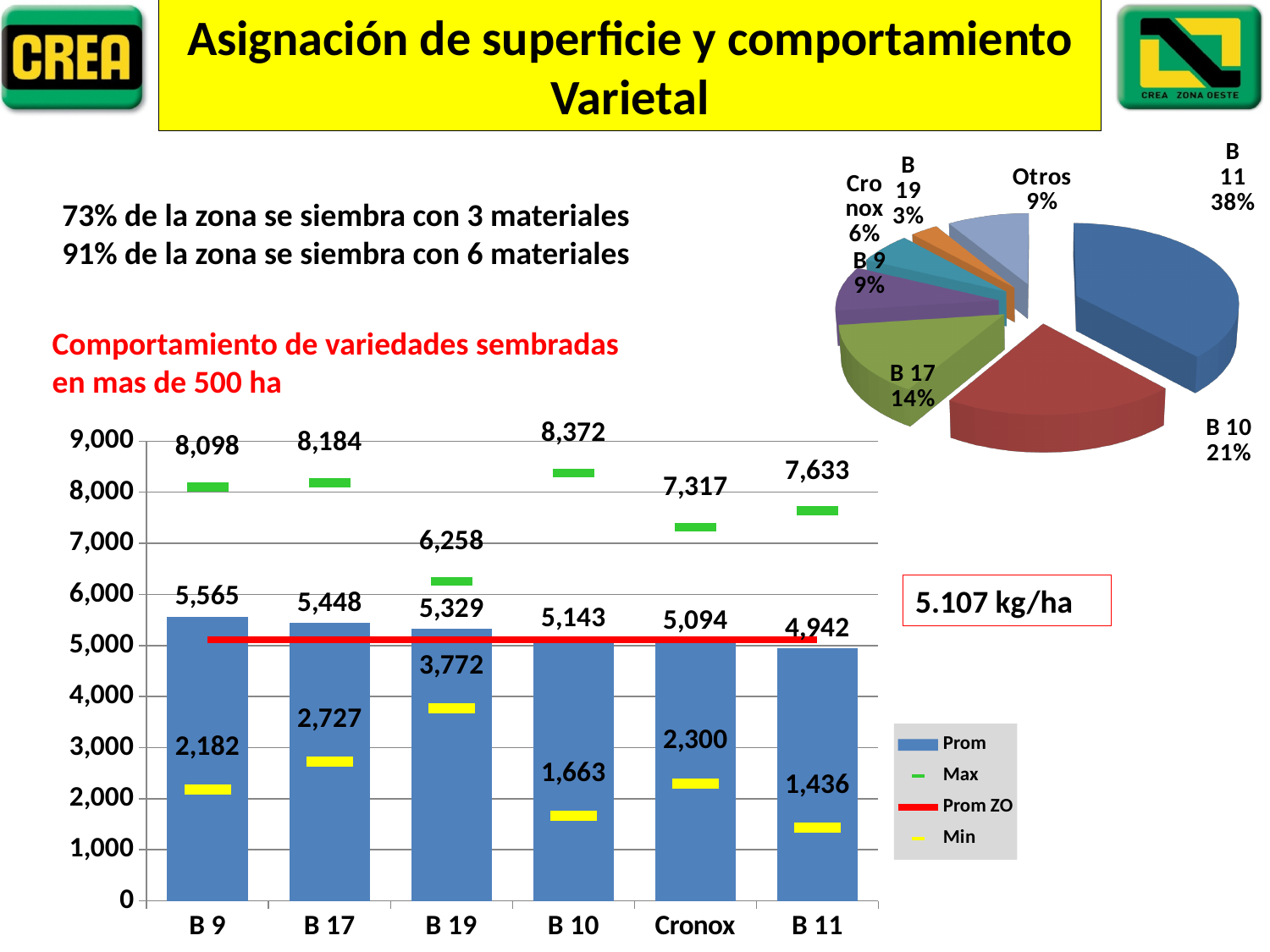
In the pie chart at the top right, which slice is the smallest? B 19 In the bar chart at the bottom left, do the Prom values rise or fall from B 9 to B 11 along the x axis? fall In the bar chart at the bottom left, what is the Min value for B 11? 1,436 In the bar chart at the bottom left, what is the difference between the Max and Min values for B 19? 2,486 In the bar chart at the bottom left, what is the Prom value for B 9? 5,565 In the bar chart at the bottom left, which category has the lowest Prom value? B 11 In the bar chart at the bottom left, what is the Max value for B 10? 8,372 In the bar chart at the bottom left, which is larger, the Prom value for B 17 or the Prom value for Cronox? B 17 In the pie chart at the top right, how many slices are there? 7 In the bar chart at the bottom left, how many series does the legend list? 4 In the pie chart at the top right, what share does B 11 have? 38% In the bar chart at the bottom left, which category has the highest Max value? B 10